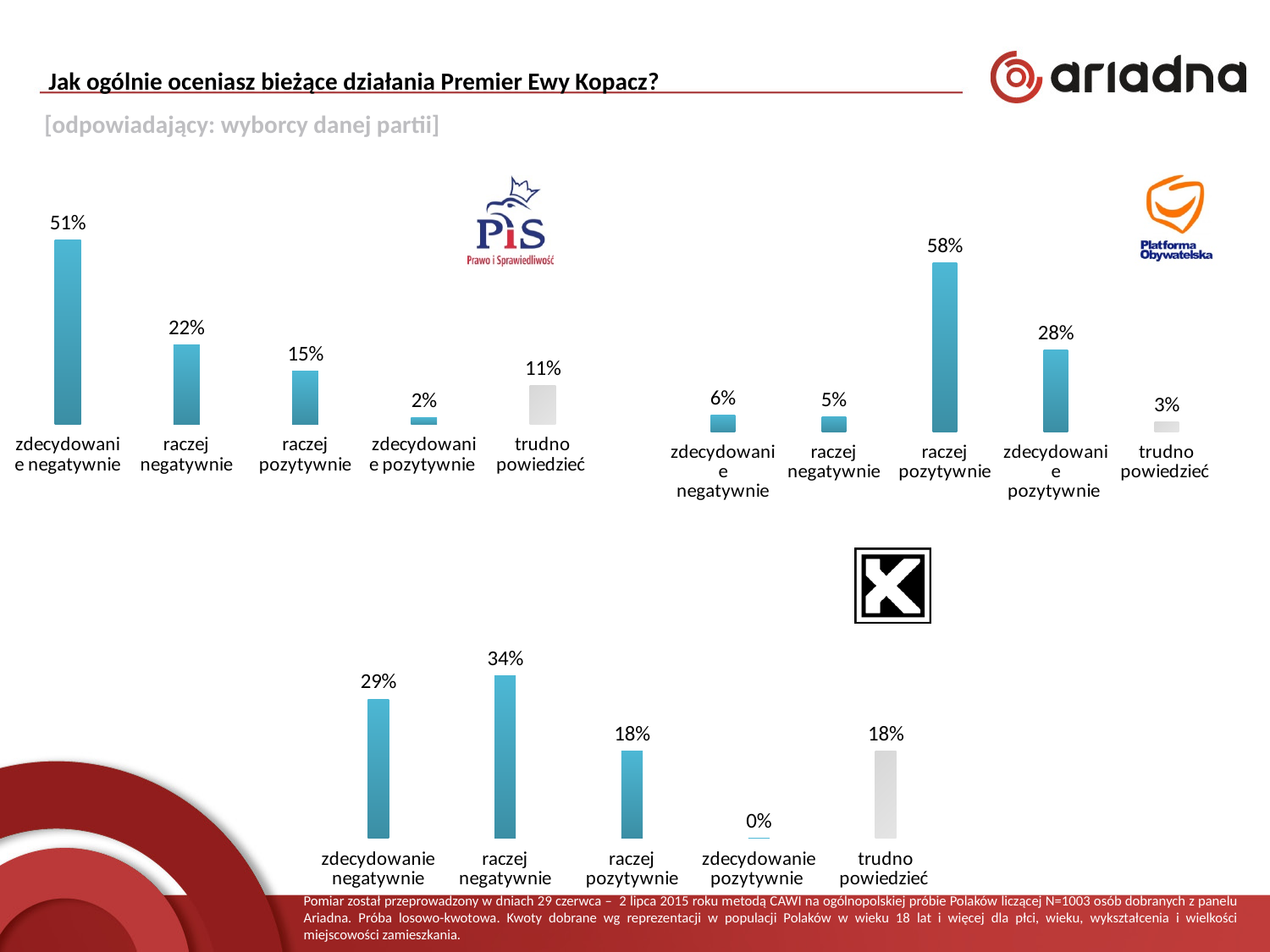
How many categories are shown in the bottom chart? 5 In the top-left chart (PiS voters), what percentage answered 'zdecydowanie negatywnie'? 51% In the bottom chart, which category has the highest value? raczej negatywnie In the top-left chart (PiS voters), which is larger: 'raczej pozytywnie' or 'trudno powiedzieć'? raczej pozytywnie What type of chart is the top-left chart (PiS voters)? bar chart In the top-right chart (Platforma Obywatelska voters), which category has the lowest value? trudno powiedzieć In the bottom chart, which is larger: 'zdecydowanie negatywnie' or 'raczej negatywnie'? raczej negatywnie In the top-left chart (PiS voters), what is the difference between 'zdecydowanie negatywnie' and 'raczej negatywnie'? 29% In the top-right chart (Platforma Obywatelska voters), what percentage answered 'raczej pozytywnie'? 58% In the bottom chart, what percentage answered 'zdecydowanie pozytywnie'? 0% In the top-right chart (Platforma Obywatelska voters), what is the difference between 'raczej pozytywnie' and 'zdecydowanie pozytywnie'? 30% In the bottom chart, what percentage answered 'trudno powiedzieć'? 18%